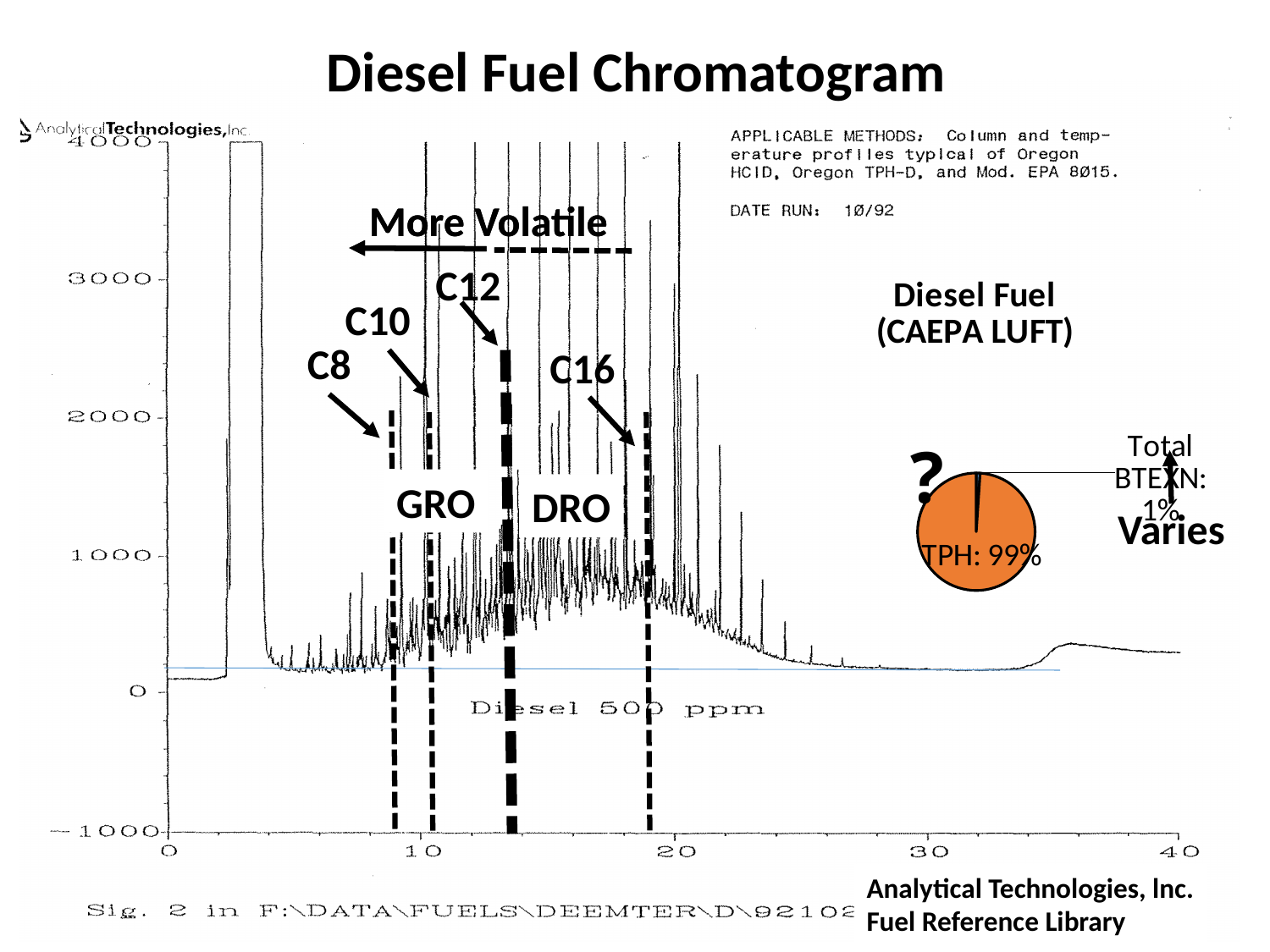
In the pie chart titled Diesel Fuel (CAEPA LUFT), which slice is the largest? TPH On the large chromatogram, what is the highest value shown on the y axis? 4000 What kind of chart is the large chromatogram on the left of the slide? Line chart On the large chromatogram, what is the highest value shown on the x axis? 40 In the pie chart titled Diesel Fuel (CAEPA LUFT), how many slices are there? 2 In the pie chart titled Diesel Fuel (CAEPA LUFT), what colour is the TPH slice? Orange In the pie chart titled Diesel Fuel (CAEPA LUFT), what share is labelled for TPH? 99% In the pie chart titled Diesel Fuel (CAEPA LUFT), what is the difference in percentage points between the TPH share and the Total BTEXN share? 98 percentage points What kind of chart is the small chart on the right of the slide titled Diesel Fuel (CAEPA LUFT)? Pie chart In the pie chart titled Diesel Fuel (CAEPA LUFT), what share is labelled for Total BTEXN? 1% In the pie chart titled Diesel Fuel (CAEPA LUFT), which is larger, the TPH share or the Total BTEXN share? TPH In the pie chart titled Diesel Fuel (CAEPA LUFT), which slice is the smallest? Total BTEXN